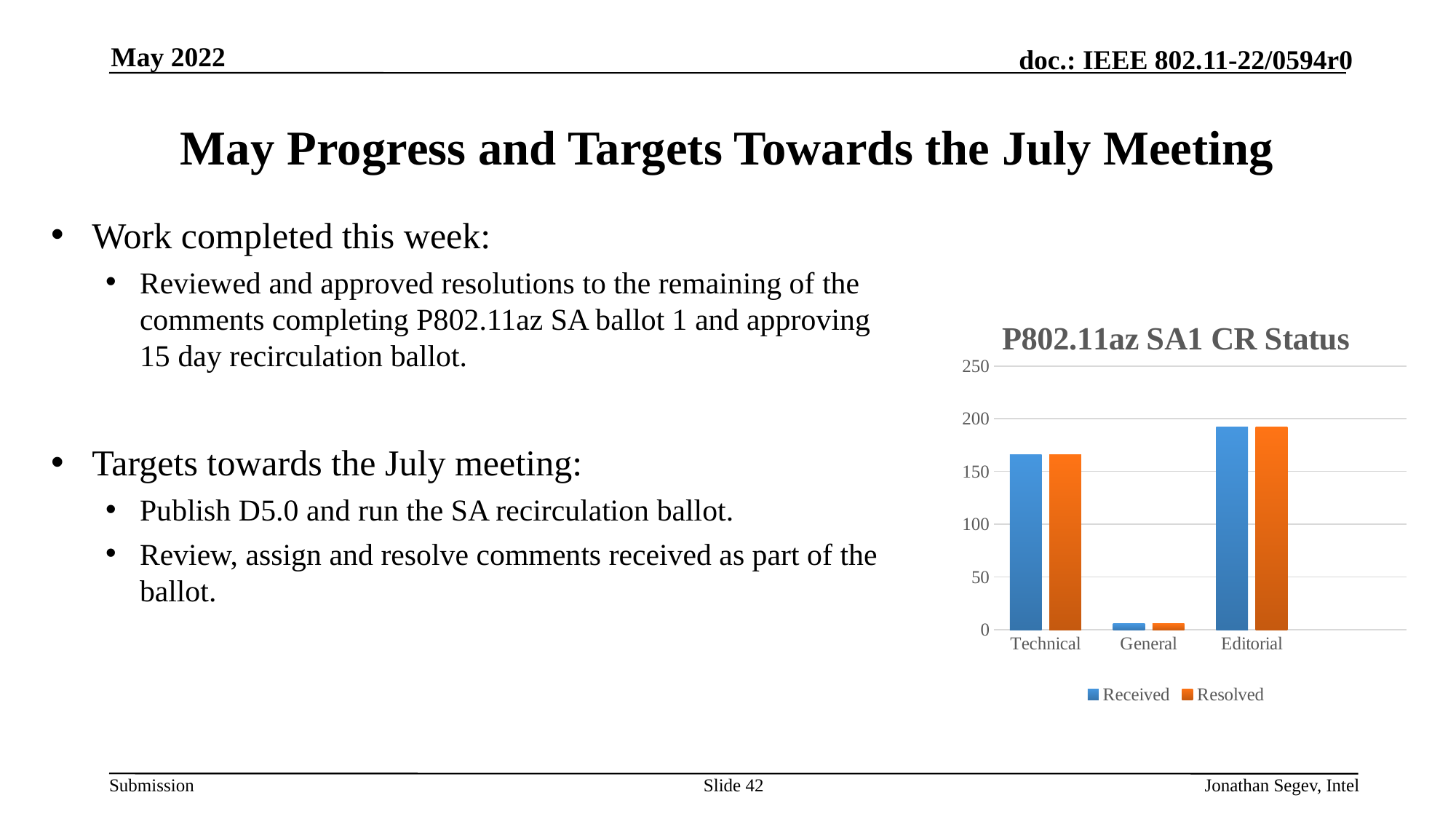
How many series does the chart's legend list? 2 Which category has the lowest Resolved value? General Is the Received value for Editorial greater or less than 150? greater Is the Resolved value for Editorial greater or less than 200? less Is the Received value for General greater or less than 50? less What kind of chart is shown on the slide? bar chart Which series is shown in orange in the chart? Resolved What is the title of the chart on the slide? P802.11az SA1 CR Status Which is larger, the Received value for Editorial or the Received value for Technical? Editorial Which category has the highest Received value? Editorial How many categories are shown on the x axis of the chart? 3